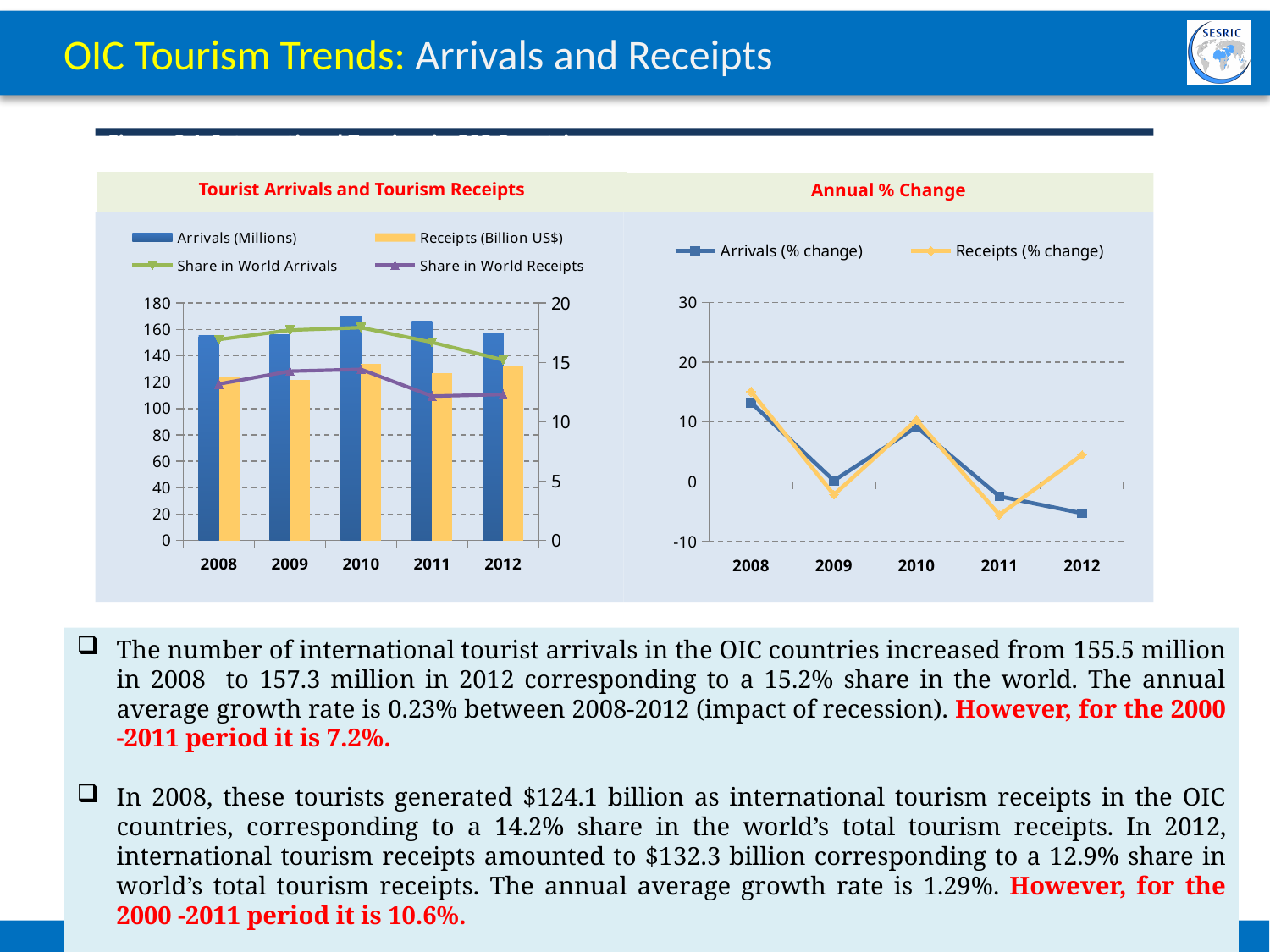
In the 'Annual % Change' chart, what kind of chart is it? line chart In the 'Tourist Arrivals and Tourism Receipts' chart, how many years are shown on the x axis? 5 In the 'Annual % Change' chart, which year has the highest Arrivals (% change) value? 2008 In the 'Tourist Arrivals and Tourism Receipts' chart, is the Receipts (Billion US$) value for 2008 greater or less than 140? less In the 'Annual % Change' chart, which year has the lowest Arrivals (% change) value? 2012 In the 'Annual % Change' chart, is the Receipts (% change) value for 2011 greater or less than 0? less In the 'Tourist Arrivals and Tourism Receipts' chart, does the Share in World Receipts line rise or fall from 2010 to 2012? fall In the 'Tourist Arrivals and Tourism Receipts' chart, how many series does the legend list? 4 In the 'Tourist Arrivals and Tourism Receipts' chart, is the Arrivals (Millions) value for 2010 greater or less than 160? greater In the 'Annual % Change' chart, which is larger in 2012: Arrivals (% change) or Receipts (% change)? Receipts (% change) In the 'Tourist Arrivals and Tourism Receipts' chart, which year has the highest Arrivals (Millions) bar? 2010 In the 'Annual % Change' chart, how many series does the legend list? 2